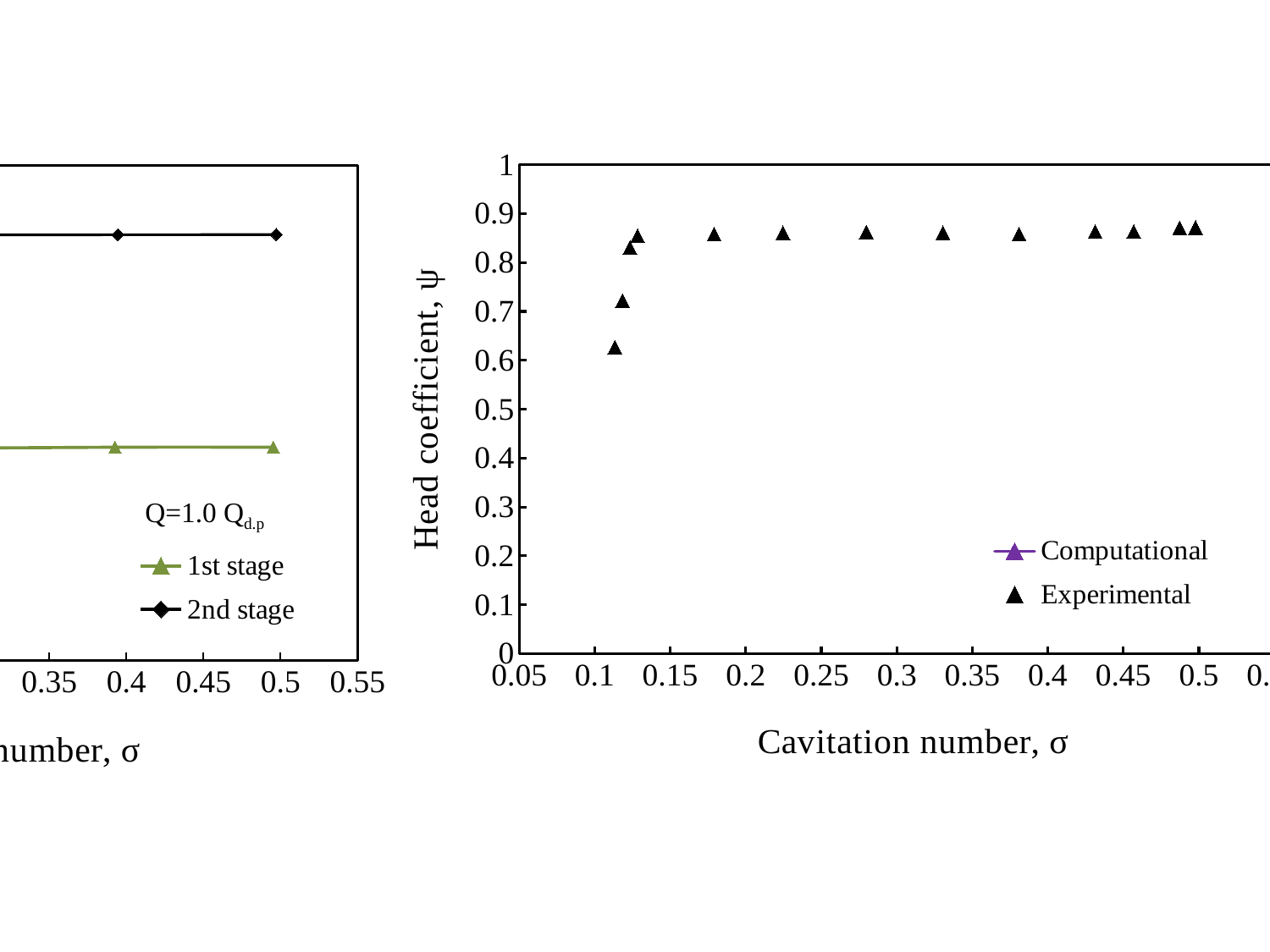
On the left chart, which series has the higher values: 1st stage or 2nd stage? 2nd stage On the right chart, what is the title of the y axis? Head coefficient, ψ On the right chart, what is the highest value shown on the y axis? 1 On the right chart, do the Experimental head coefficient values rise or fall as the cavitation number increases from 0.1 to 0.15? rise On the right chart, is the Experimental head coefficient at the smallest plotted cavitation number (about 0.11) greater or less than 0.7? less On the right chart, what is the title of the x axis? Cavitation number, σ On the left chart, do the 2nd stage values rise, fall or stay flat between cavitation numbers 0.4 and 0.5? stay flat On the right chart, which Experimental point has the lowest head coefficient: the one at a cavitation number of about 0.11 or the one at about 0.18? about 0.11 On the right chart, how many series does the legend list? 2 On the right chart, is the Experimental head coefficient at a cavitation number of 0.3 greater or less than 0.8? greater On the left chart, how many series does the legend list? 2 What kind of chart is the left chart? line chart